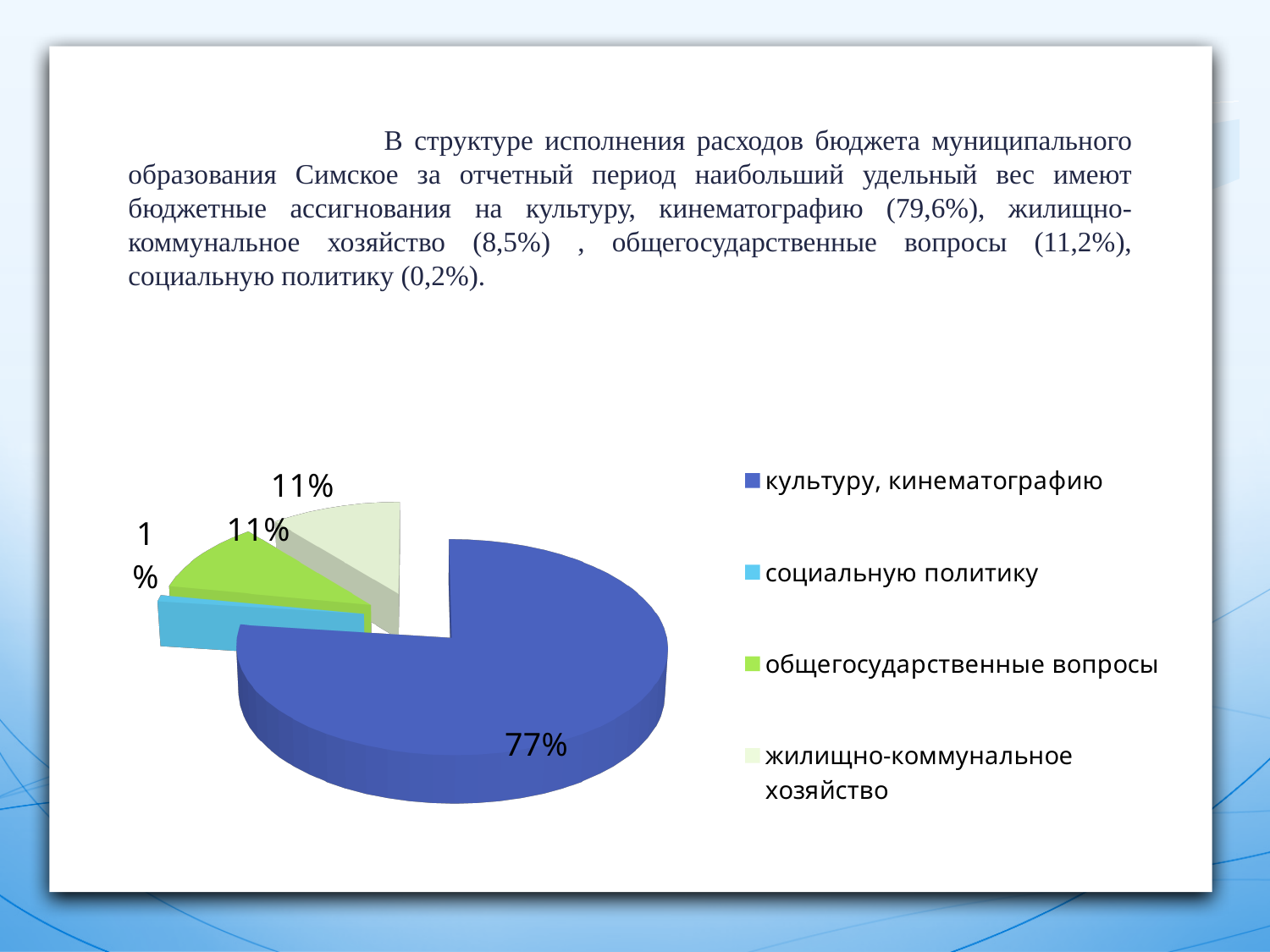
Which category has the largest slice of the pie? культуру, кинематографию Which category has the smallest slice of the pie? социальную политику What share of the pie is labelled for жилищно-коммунальное хозяйство? 11% What kind of chart is shown on the slide? pie chart How many slices does the pie chart have? 4 Which legend entry is shown in dark blue? культуру, кинематографию What share of the pie is labelled for культуру, кинематографию? 77% What share of the pie is labelled for социальную политику? 1% How many entries does the legend of the pie chart list? 4 Which is larger: the slice for культуру, кинематографию or the slice for общегосударственные вопросы? культуру, кинематографию What is the difference in percentage points between the slice for культуру, кинематографию and the slice for жилищно-коммунальное хозяйство? 66%